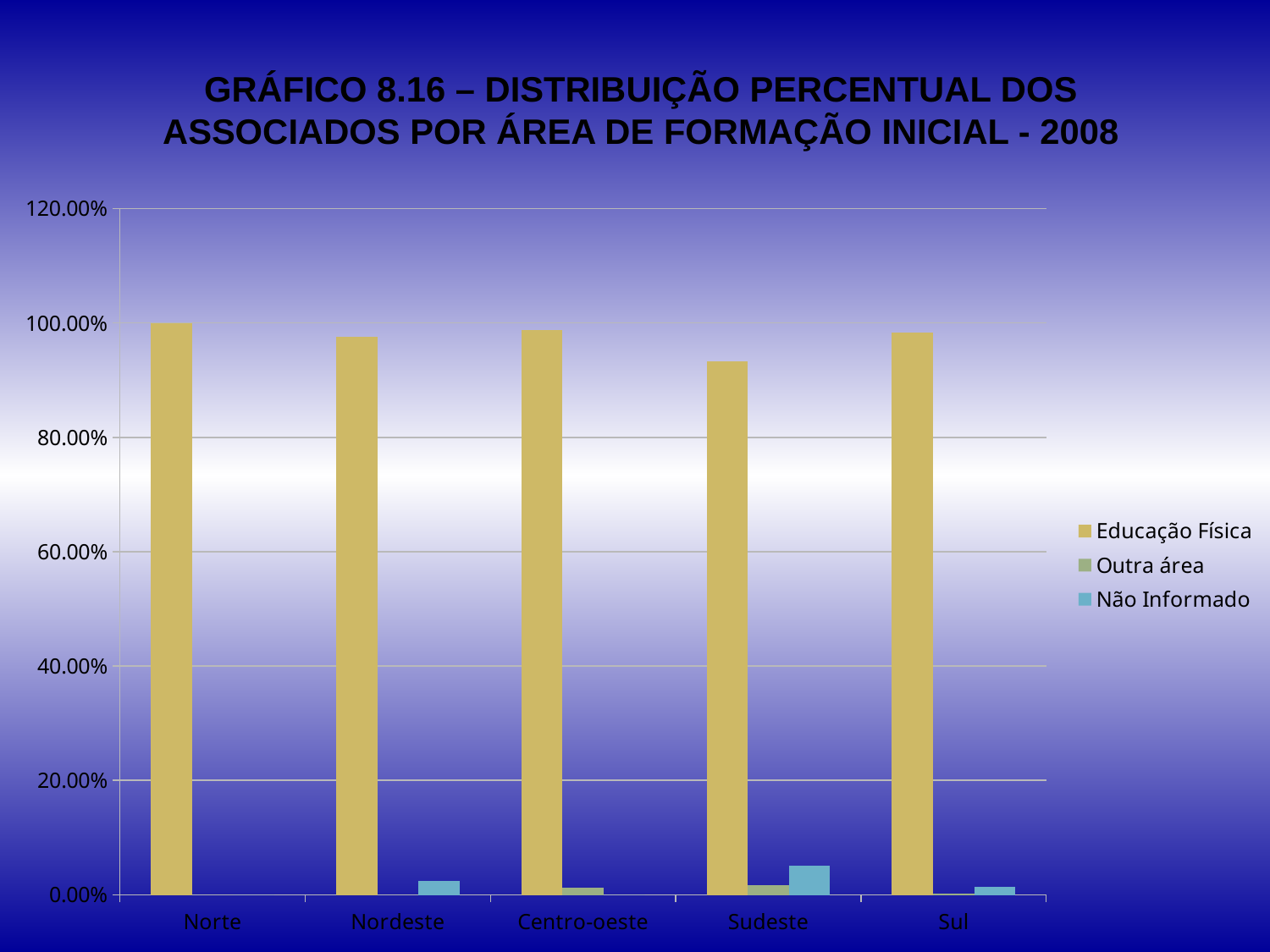
Which region has the highest value for Não Informado? Sudeste How many series does the legend list? 3 For Sudeste, which is larger, the Outra área value or the Não Informado value? Não Informado Is the Educação Física value for Norte greater or less than 80.00%? greater Which region has a larger Não Informado value, Nordeste or Sudeste? Sudeste Which region has the lowest value for Educação Física? Sudeste Which region has a larger Educação Física value, Sudeste or Nordeste? Nordeste How many regions (categories) are shown on the x axis? 5 Is the Educação Física value for Sudeste greater or less than 80.00%? greater Is the Não Informado value for Sudeste greater or less than 20.00%? less What kind of chart is shown on the slide? bar chart What is the title of the chart? GRÁFICO 8.16 – DISTRIBUIÇÃO PERCENTUAL DOS ASSOCIADOS POR ÁREA DE FORMAÇÃO INICIAL - 2008